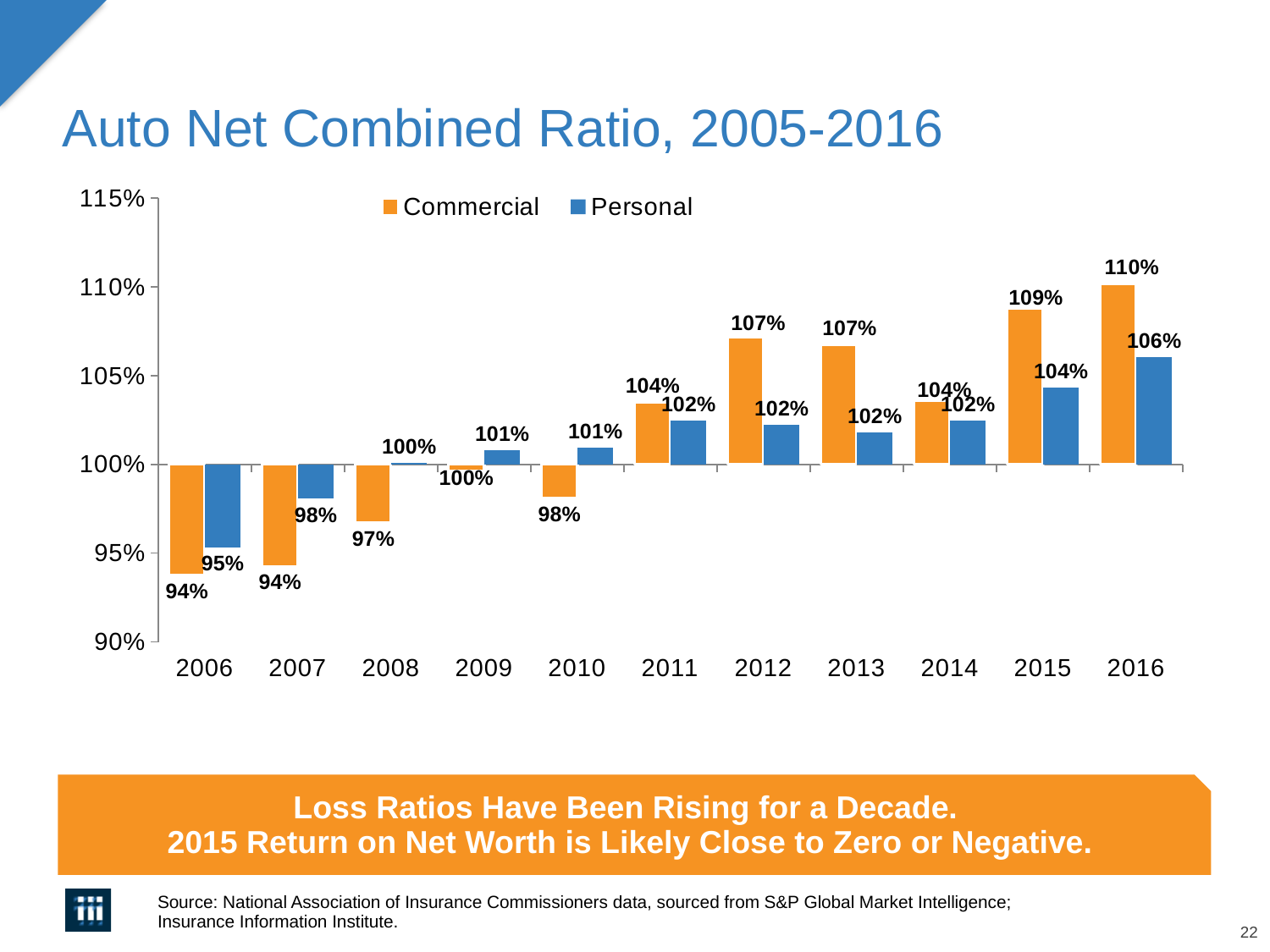
How many years are shown on the x axis? 11 In which year is the Personal combined ratio highest? 2016 What is the difference between the Commercial and Personal values in 2015? 5% What is the Personal auto net combined ratio for 2007? 98% In which year is the Commercial combined ratio highest? 2016 What is the Commercial auto net combined ratio for 2016? 110% Which is larger in 2008, the Commercial or the Personal combined ratio? Personal In which year is the Personal combined ratio lowest? 2006 Which is larger in 2013, the Commercial or the Personal combined ratio? Commercial How many series does the legend list? 2 What kind of chart is shown on the slide? Bar chart What is the Commercial value for 2012? 107%